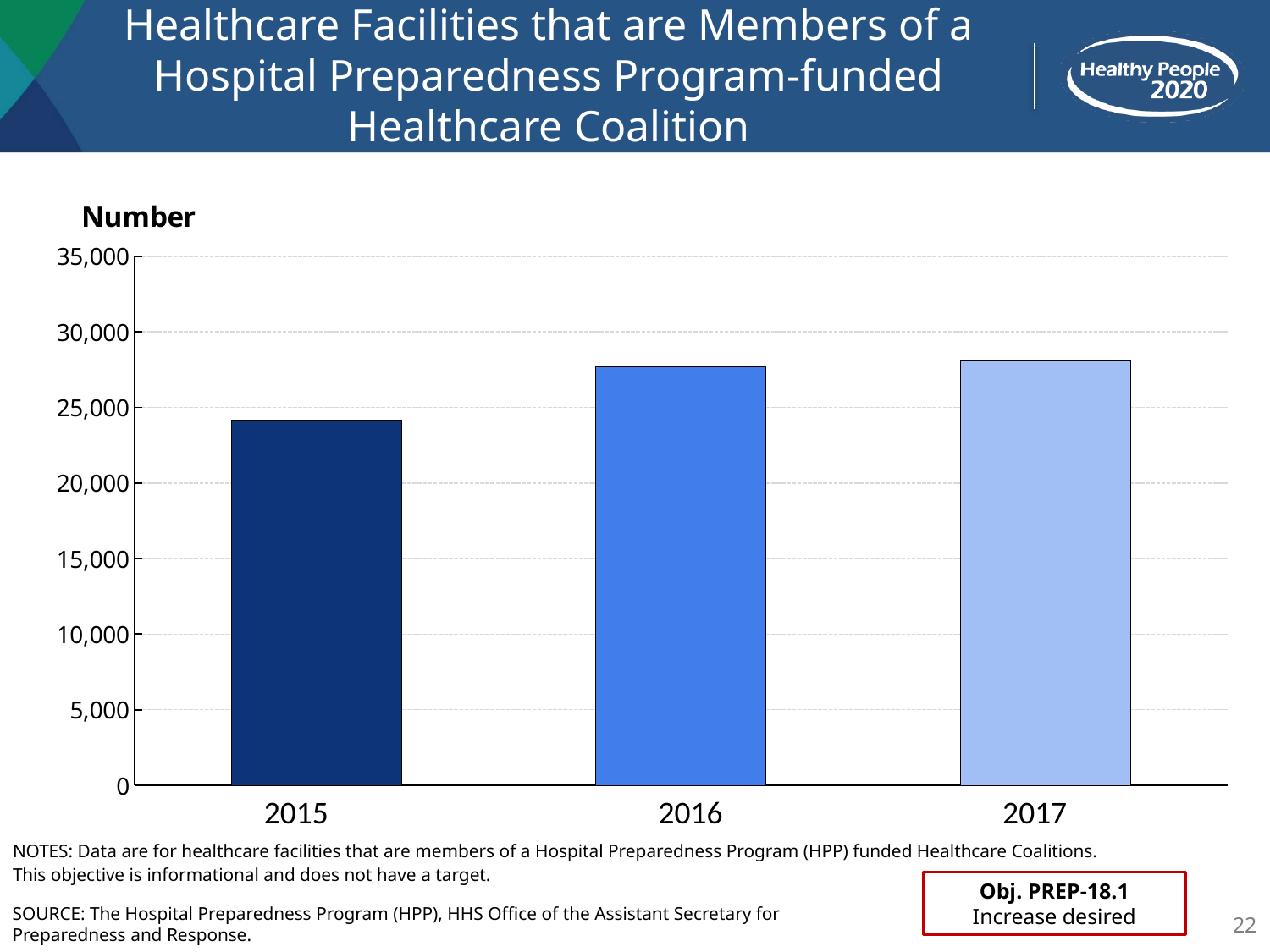
Which is larger, the value for 2015 or the value for 2016? 2016 Is the value for 2015 greater or less than 20,000? greater Is the value for 2015 greater or less than 25,000? less Is the value for 2016 greater or less than 25,000? greater Which year has the lowest number of healthcare facilities? 2015 Do the values rise or fall from 2015 to 2017? rise What is the label on the vertical axis of the chart? Number What objective number is shown in the box at the bottom right of the slide? Obj. PREP-18.1 What kind of chart is shown on the slide? bar chart How many years are plotted on the chart? 3